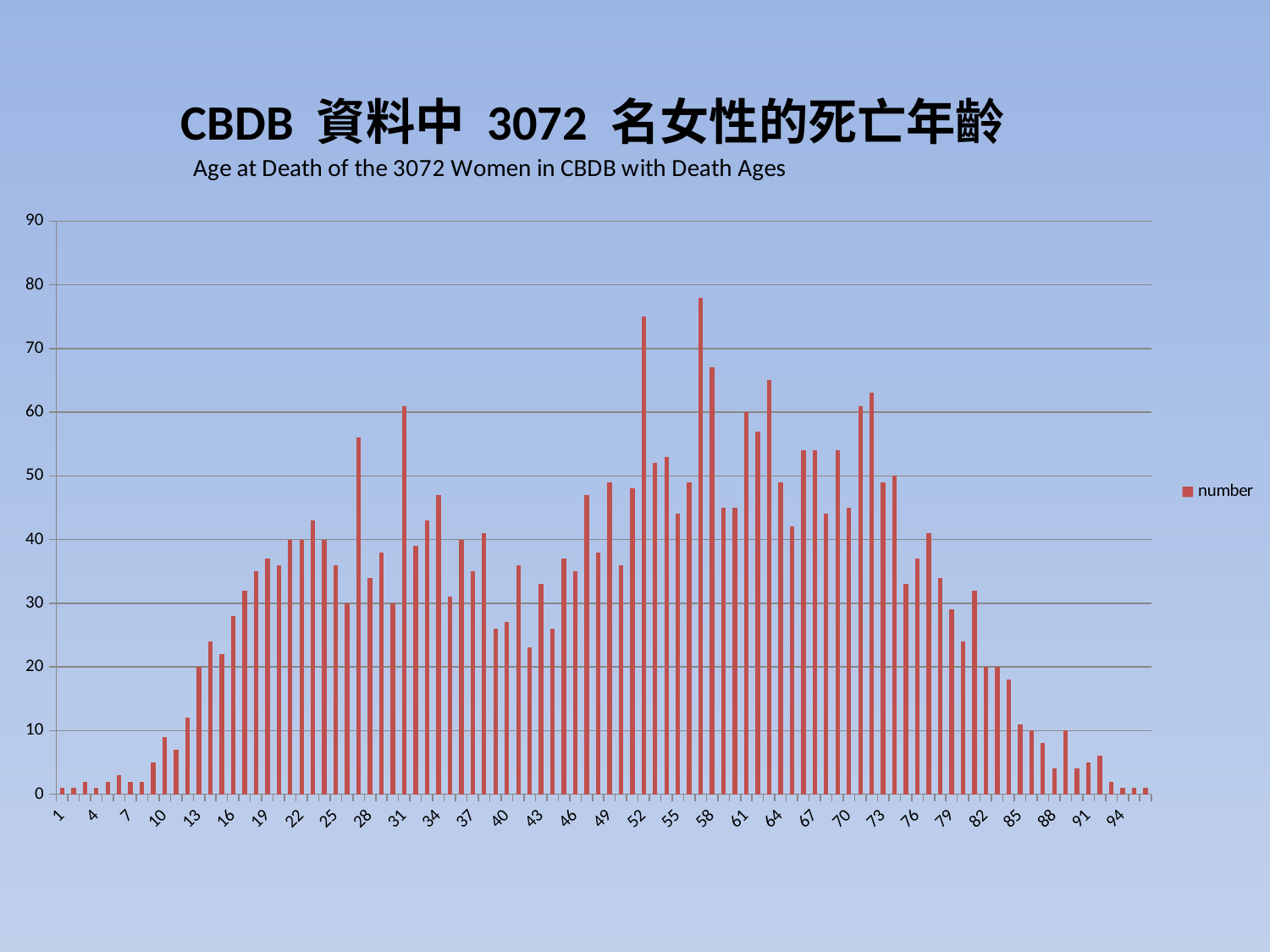
Is the value for age 1 greater or less than 10? less Do the values generally rise or fall from age 73 to age 94? fall Is the value for age 58 greater or less than 70? less Is the value for age 85 greater or less than 20? less What is the name of the series shown in the legend? number Do the values generally rise or fall from age 1 to age 19? rise What kind of chart is shown on the slide? bar chart What is the English subtitle of the chart? Age at Death of the 3072 Women in CBDB with Death Ages How many series does the legend list? 1